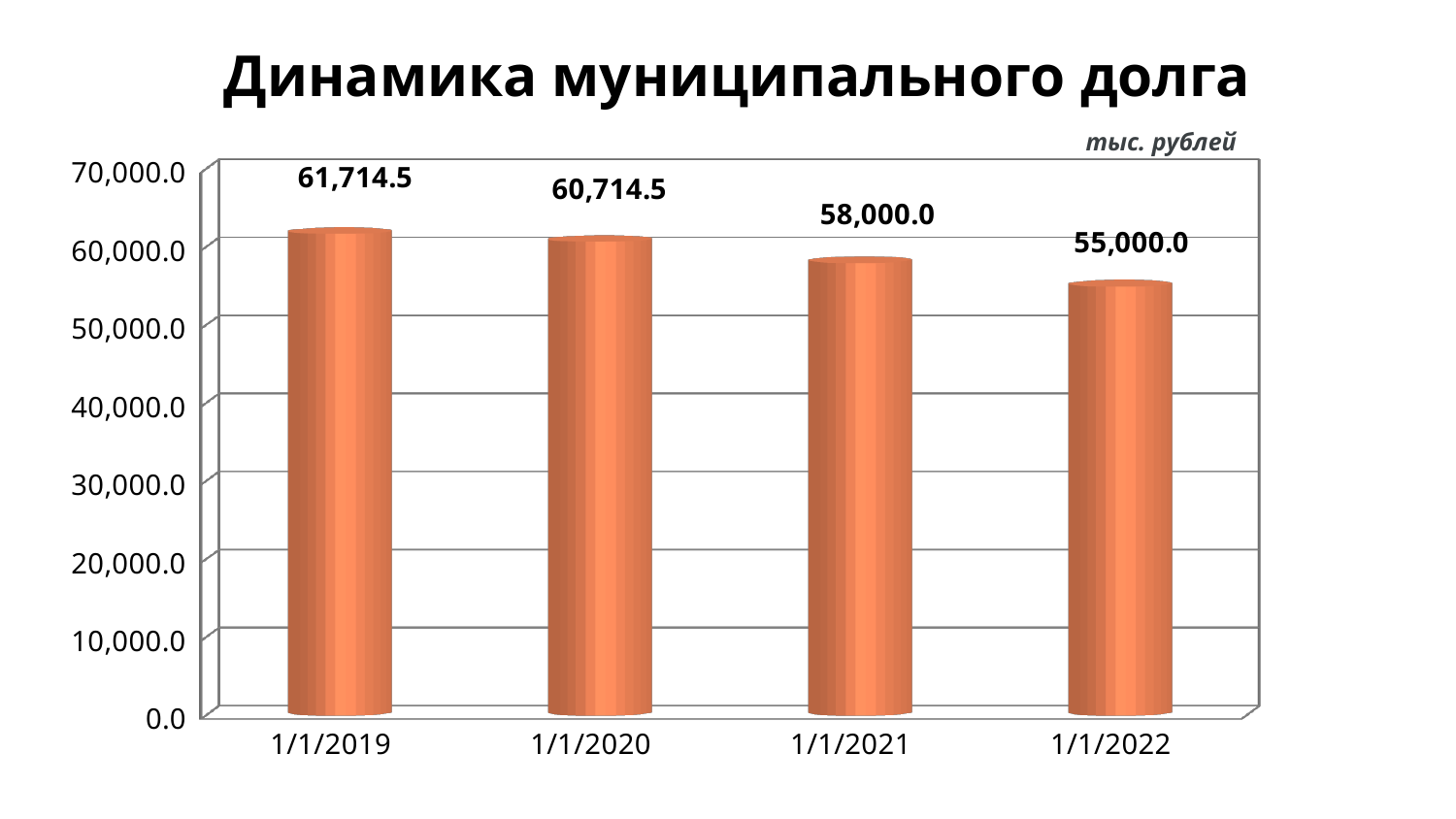
What kind of chart is shown on the slide? bar chart Do the values rise or fall from 1/1/2019 to 1/1/2022? fall What is the value for 1/1/2022? 55,000.0 What is the value for 1/1/2019? 61,714.5 What is the value for 1/1/2021? 58,000.0 Which is larger, the value for 1/1/2020 or the value for 1/1/2021? 1/1/2020 What is the difference between the values for 1/1/2019 and 1/1/2020? 1,000.0 Is the value for 1/1/2022 greater or less than 60,000.0? less How many dates are shown on the x axis? 4 Which date has the highest value? 1/1/2019 Which date has the lowest value? 1/1/2022 What is the difference between the values for 1/1/2021 and 1/1/2022? 3,000.0